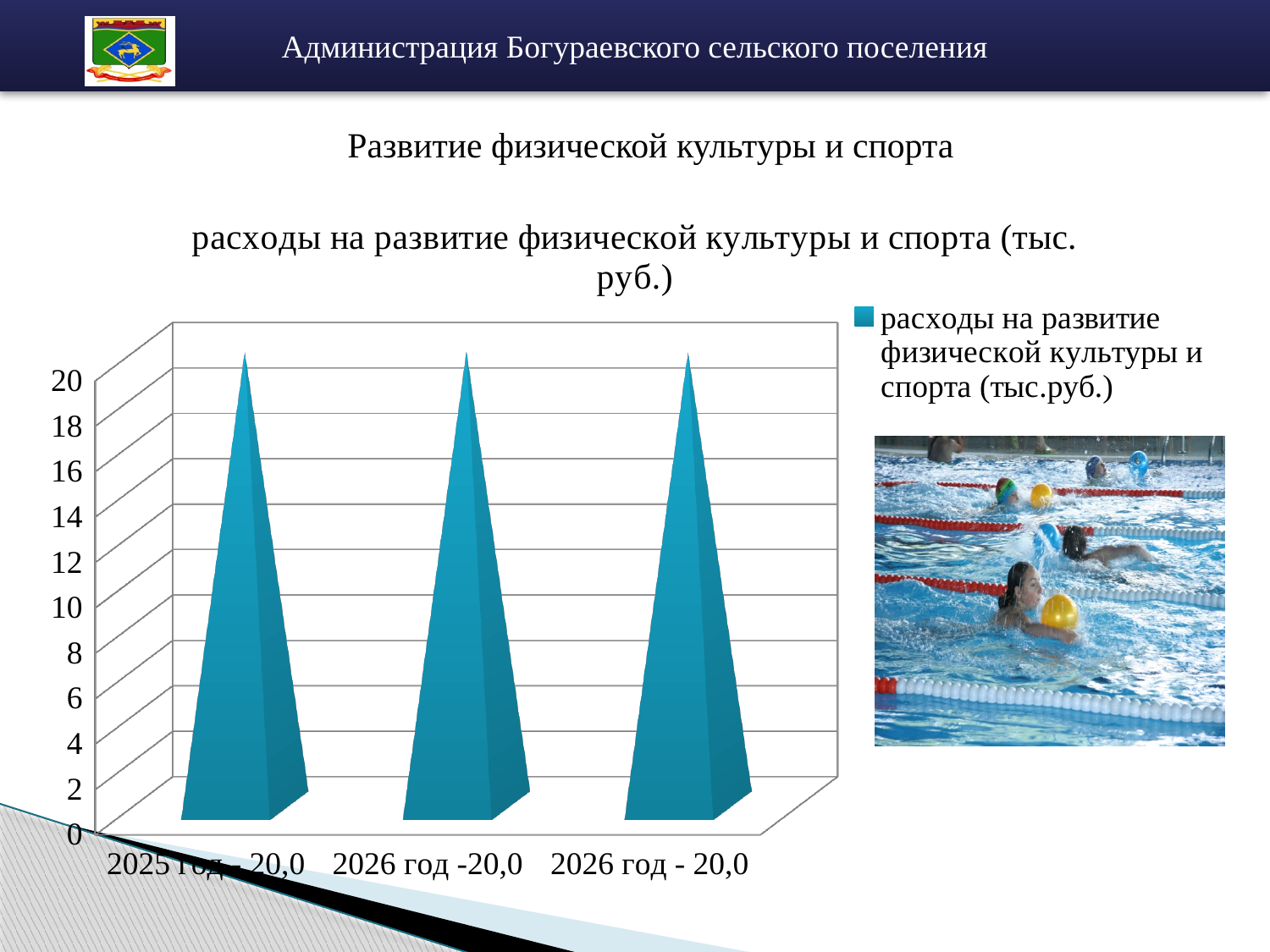
Is the value for the last category greater or less than 14? greater What value is shown for the first 2026 год category? 20,0 How many series does the chart legend list? 1 What value is shown for 2025 год? 20,0 How many categories are plotted on the chart? 3 Is the value for 2025 год greater or less than 10? greater What value is shown for the last category on the x axis? 20,0 What kind of chart is shown on the slide? bar chart What is the legend entry of the chart? расходы на развитие физической культуры и спорта (тыс.руб.) Do the values rise, fall or stay the same across the categories on the x axis? stay the same What is the title of the chart? расходы на развитие физической культуры и спорта (тыс. руб.) What is the highest tick value shown on the vertical axis? 20